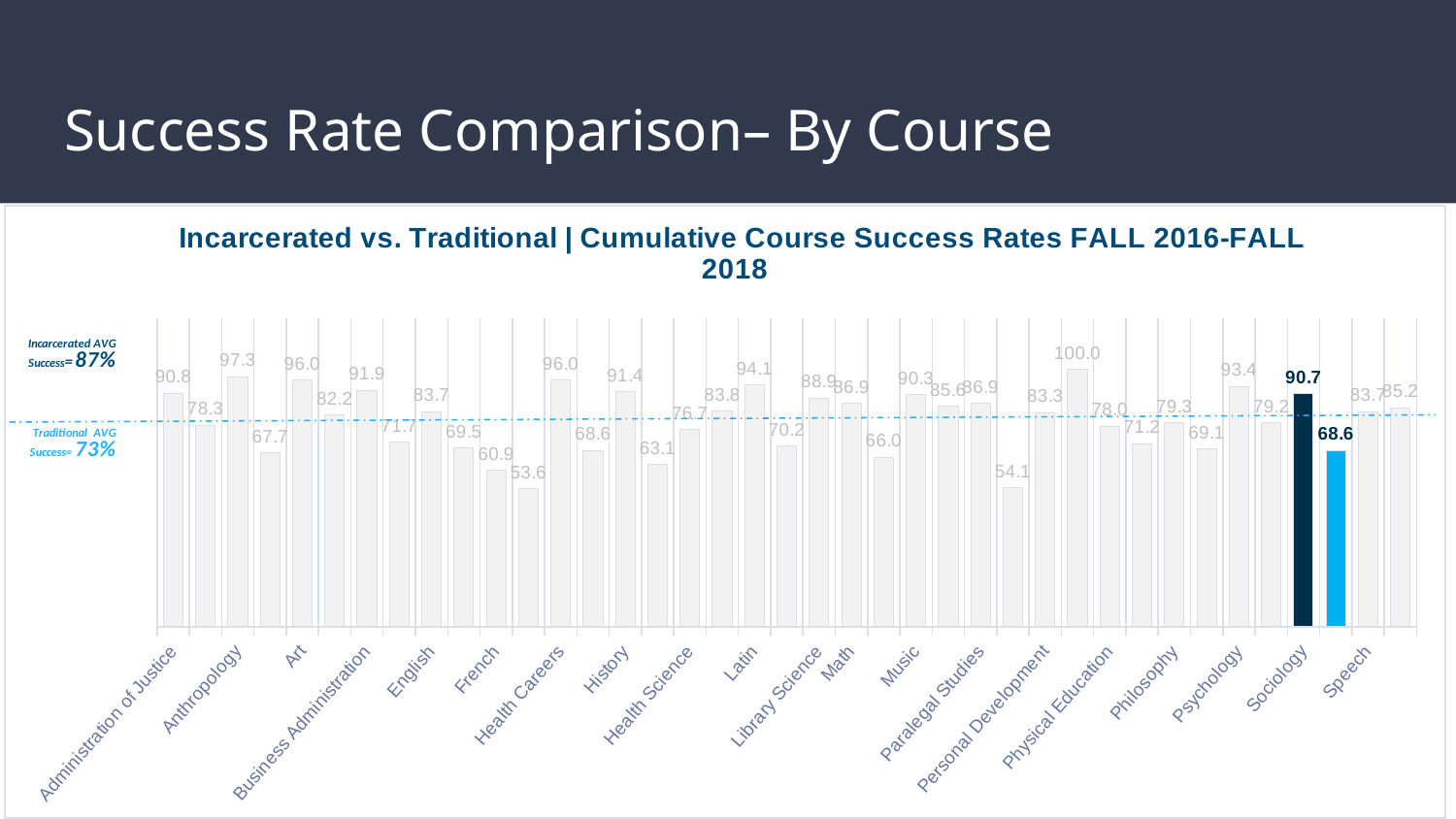
For Sociology, which highlighted bar is larger, the dark navy one or the light blue one? The dark navy one What is the highest value labelled on any bar in the chart? 100.0 How many courses are listed along the x axis of the chart? 20 Which course has its bars highlighted in colour rather than grey? Sociology What is the lowest value labelled on any bar in the chart? 53.6 What kind of chart is shown on the slide? Bar chart What is the title of the chart? Incarcerated vs. Traditional | Cumulative Course Success Rates FALL 2016-FALL 2018 What is the value of the dark navy highlighted bar for Sociology? 90.7 What is the value of the light blue highlighted bar for Sociology? 68.6 What is the Traditional AVG Success rate noted on the left of the chart? 73% What is the Incarcerated AVG Success rate noted on the left of the chart? 87% What is the difference between the two highlighted Sociology bars (90.7 and 68.6)? 22.1